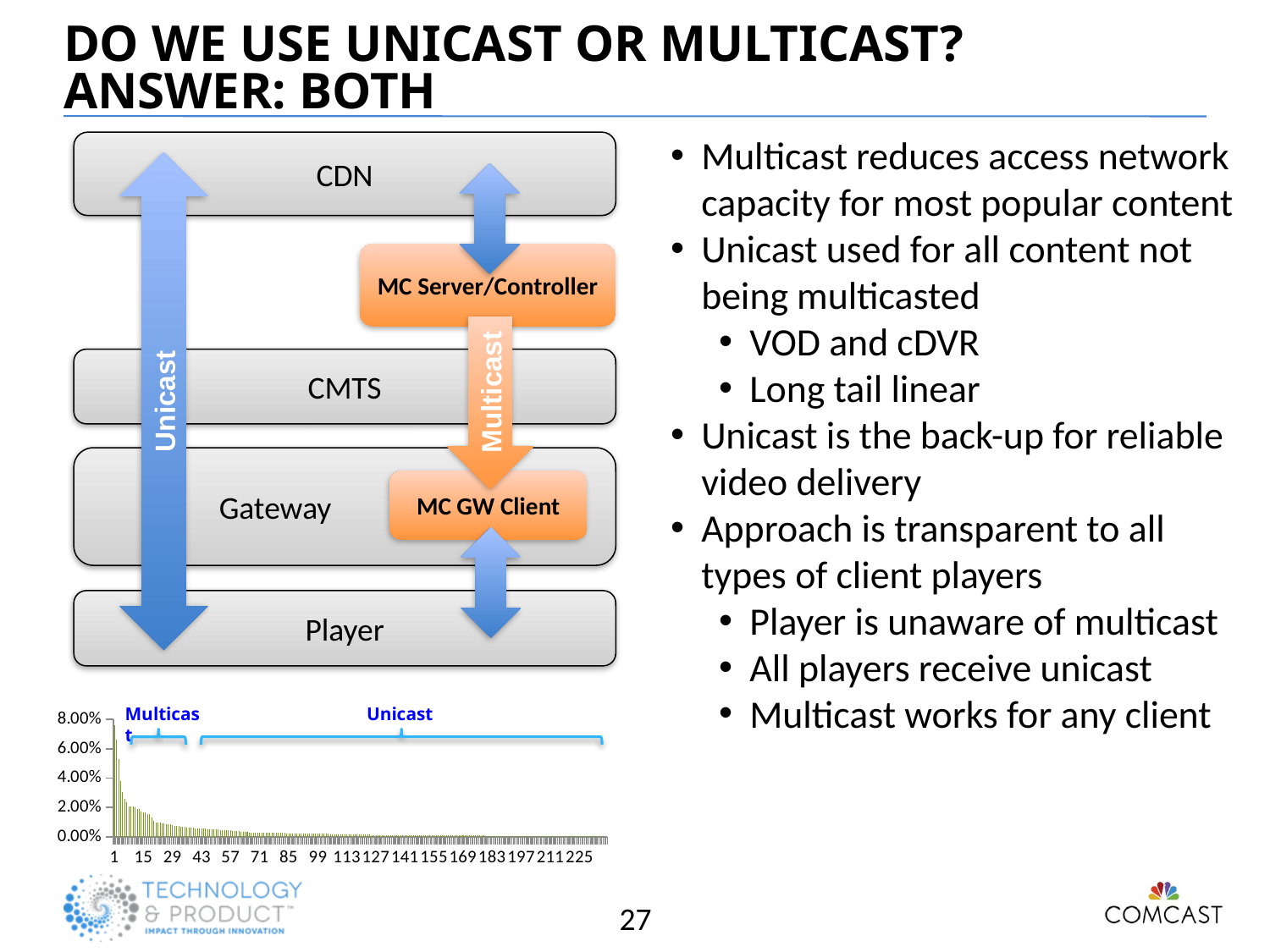
In the bar chart at the bottom left, which is larger, the value for category 1 or the value for category 43? category 1 In the bar chart at the bottom left, which x-axis category has the highest value? 1 What kind of chart is shown at the bottom left of the slide? bar chart In the bar chart at the bottom left, is the value for category 225 greater or less than 2.00%? less In the bar chart at the bottom left, which label is placed over the leftmost group of bars, Multicast or Unicast? Multicast In the bar chart at the bottom left, is the value for category 1 greater or less than 4.00%? greater What is the highest value shown on the y axis of the bar chart at the bottom left? 8.00% In the bar chart at the bottom left, is the value for category 99 greater or less than 2.00%? less In the bar chart at the bottom left, do the values rise or fall as you move from left to right along the x axis? fall